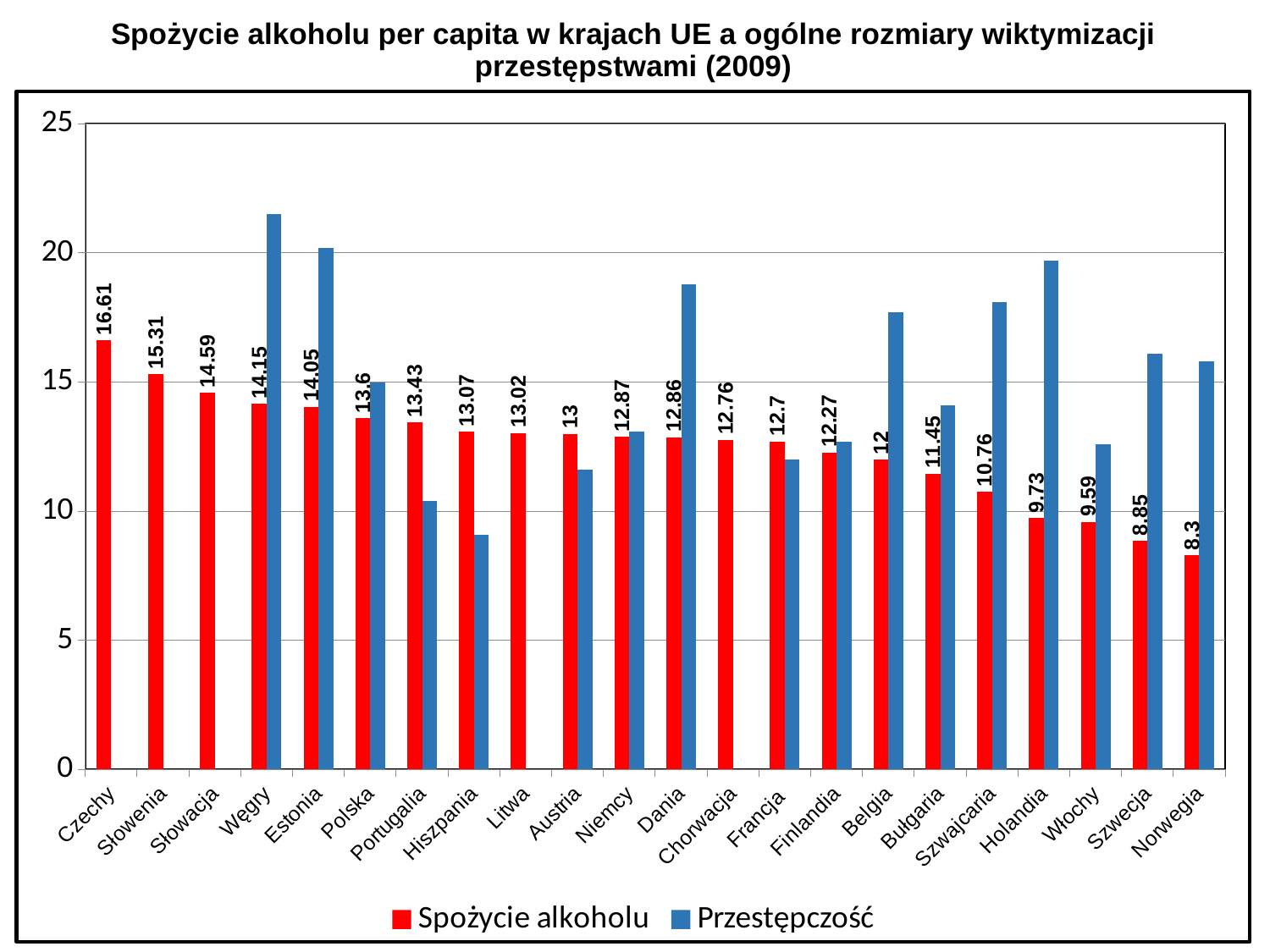
What is the difference between the Spożycie alkoholu values for Czechy and Norwegia? 8.31 How many countries are shown on the x axis? 22 Which has the larger Spożycie alkoholu value, Węgry or Estonia? Węgry Which country has the lowest Spożycie alkoholu value? Norwegia Do the Spożycie alkoholu values rise or fall from left to right along the x axis? fall Is the Przestępczość value for Hiszpania greater or less than 10? less How many series does the legend list? 2 Which country has the highest Przestępczość value? Węgry What is the value of Spożycie alkoholu for Czechy? 16.61 Which country has the highest Spożycie alkoholu value? Czechy What is the value of Spożycie alkoholu for Polska? 13.6 Is the Przestępczość value for Węgry greater or less than 20? greater